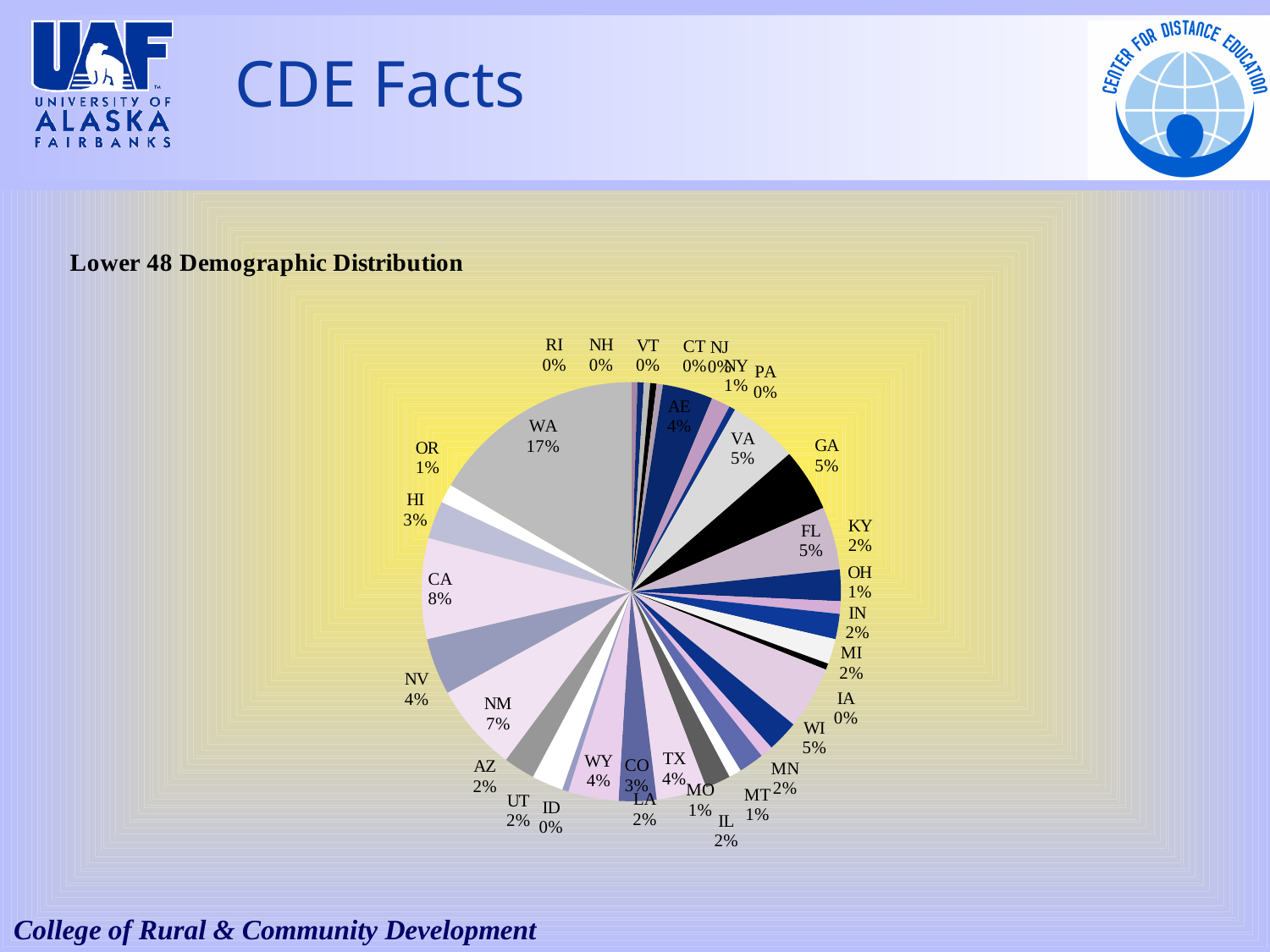
What is the difference between the shares for WA and CA? 9% Which is larger, the share for CA or the share for NM? CA What is the value shown for CO? 3% What share of the pie does WA represent? 17% What is the value shown for CA? 8% What type of chart is shown on the slide? pie chart What is the value shown for HI? 3% What is the title of the chart? Lower 48 Demographic Distribution What is the value shown for TX? 4% Which is larger, the share for WI or the share for MN? WI What is the value shown for NM? 7% Which state has the largest slice of the pie? WA